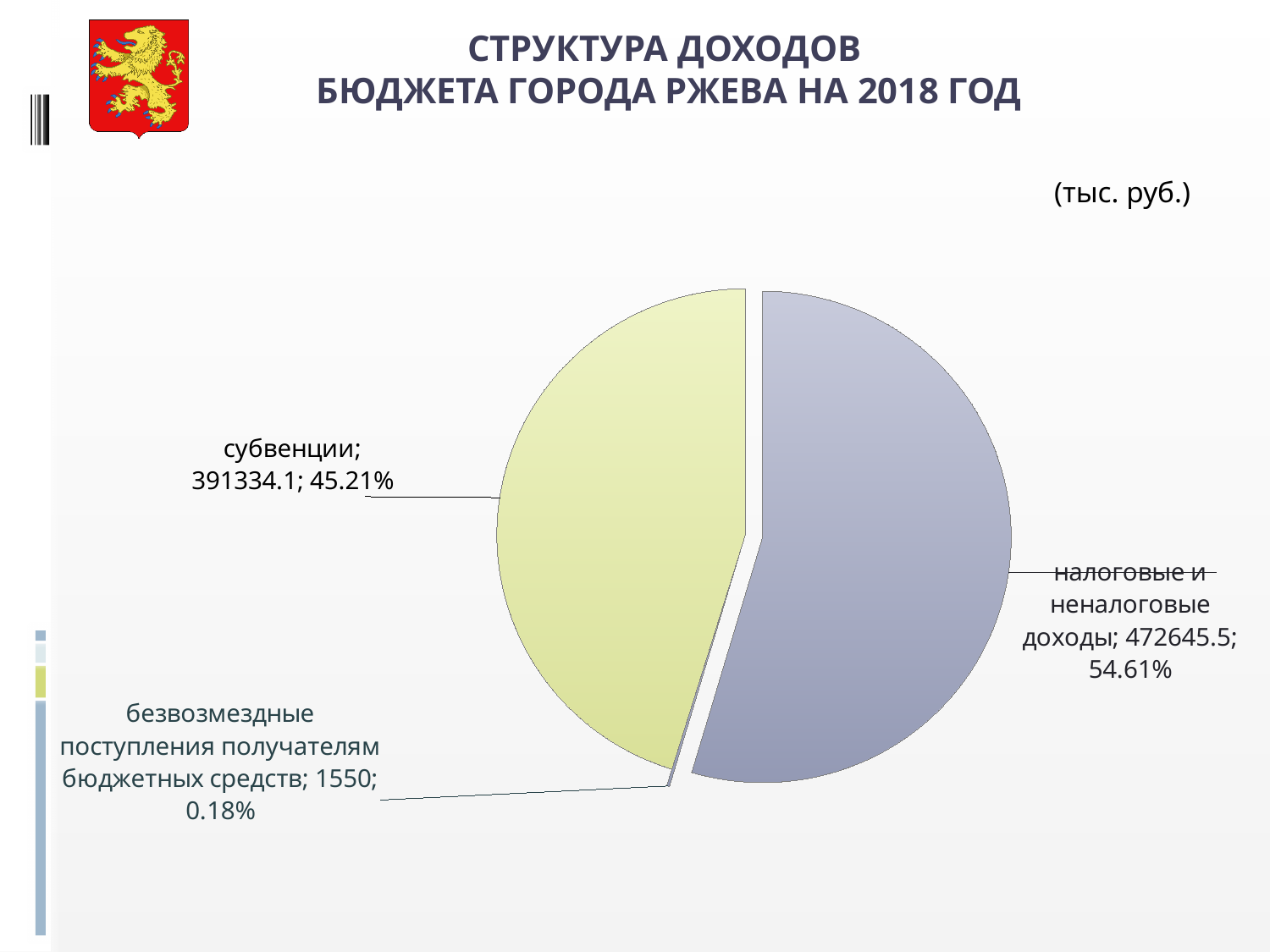
What share of the pie does безвозмездные поступления получателям бюджетных средств represent? 0.18% What is the value for безвозмездные поступления получателям бюджетных средств? 1550 Which category has the smallest slice? безвозмездные поступления получателям бюджетных средств What kind of chart is shown on the slide? pie chart What unit is stated for the values on the chart? тыс. руб. What is the difference between the values for налоговые и неналоговые доходы and субвенции? 81311.4 What is the value for налоговые и неналоговые доходы? 472645.5 What share of the pie does субвенции represent? 45.21% What share of the pie does налоговые и неналоговые доходы represent? 54.61% What is the value for субвенции? 391334.1 Which category has the largest slice? налоговые и неналоговые доходы How many slices does the pie chart have? 3